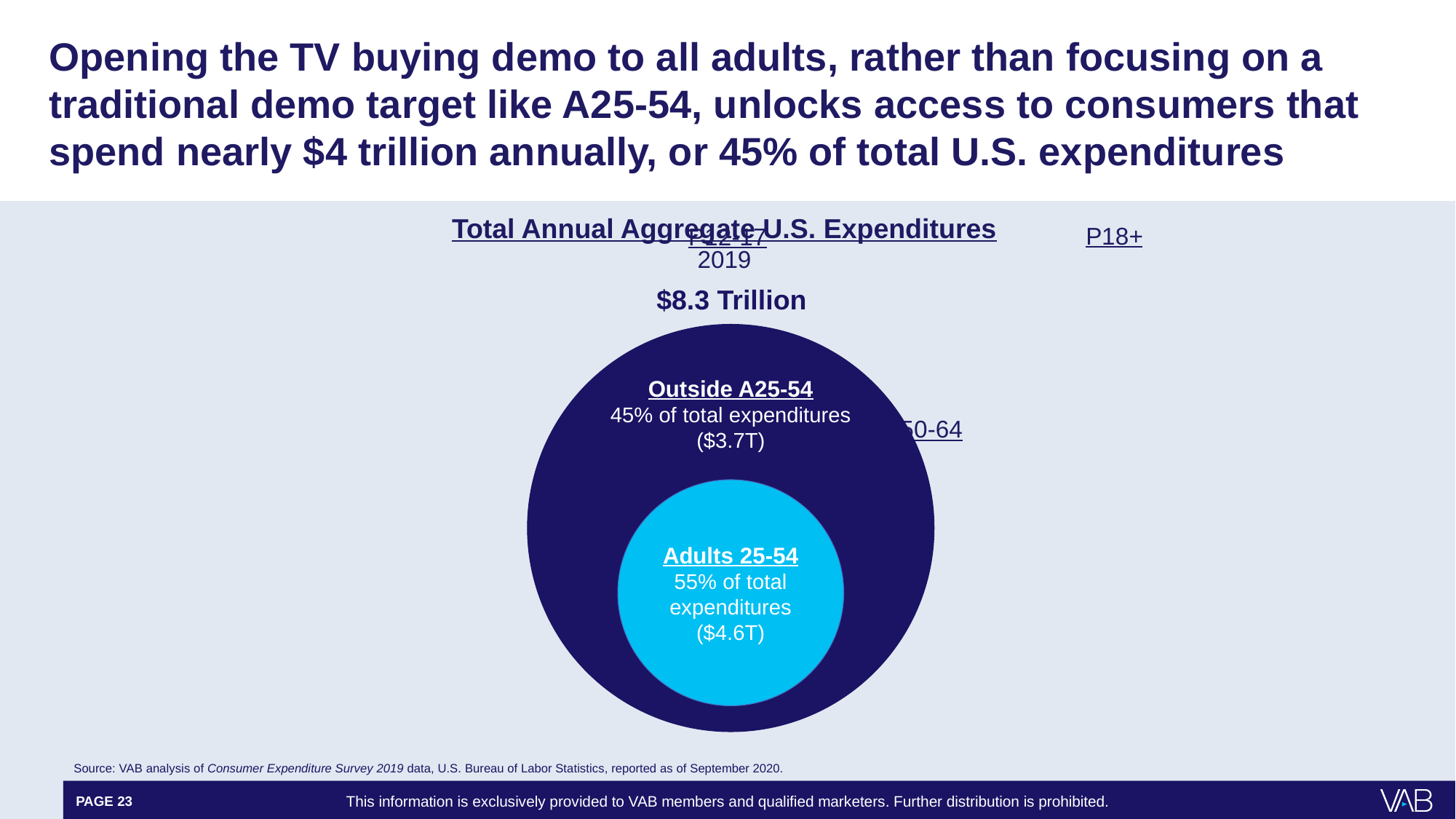
What dollar amount of expenditures is shown for the Outside A25-54 group? $3.7T What year does the Total Annual Aggregate U.S. Expenditures chart refer to? 2019 How many consumer groups are shown in the circle diagram? 2 What is the total annual aggregate U.S. expenditure figure shown above the circles? $8.3 Trillion What dollar amount of expenditures is shown for Adults 25-54? $4.6T By how many percentage points does the Adults 25-54 share exceed the Outside A25-54 share? 10 percentage points What colour is the inner circle representing Adults 25-54? Light blue What share of total expenditures is attributed to Adults 25-54? 55% Which group has the smaller share of total expenditures? Outside A25-54 What share of total expenditures is attributed to consumers outside A25-54? 45% What is the difference in dollars between the Adults 25-54 expenditures ($4.6T) and the Outside A25-54 expenditures ($3.7T)? $0.9T Which group accounts for the larger share of total expenditures, Adults 25-54 or Outside A25-54? Adults 25-54